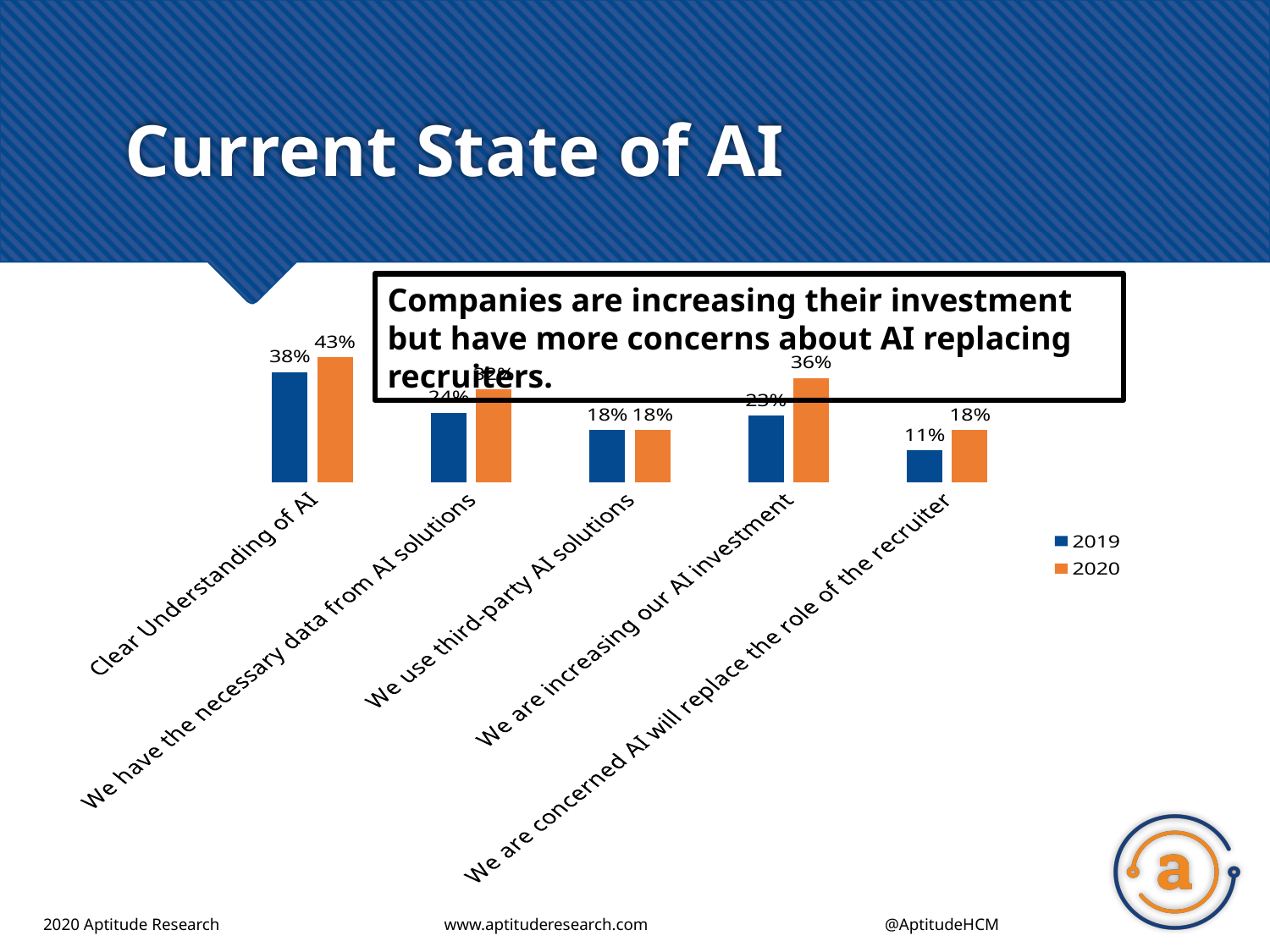
What is the 2020 value for "Clear Understanding of AI"? 43% How many categories are shown on the x axis? 5 What is the difference between the 2020 and 2019 values for "We are concerned AI will replace the role of the recruiter"? 7% What is the 2019 value for "Clear Understanding of AI"? 38% What is the 2020 value for "We use third-party AI solutions"? 18% What type of chart is shown on the slide? bar chart What is the 2019 value for "We are concerned AI will replace the role of the recruiter"? 11% How many series does the legend list? 2 Which series is shown in orange in the legend? 2020 What is the 2020 value for "We are increasing our AI investment"? 36% Which category has the lowest 2019 value? We are concerned AI will replace the role of the recruiter Which category has the highest 2020 value? Clear Understanding of AI